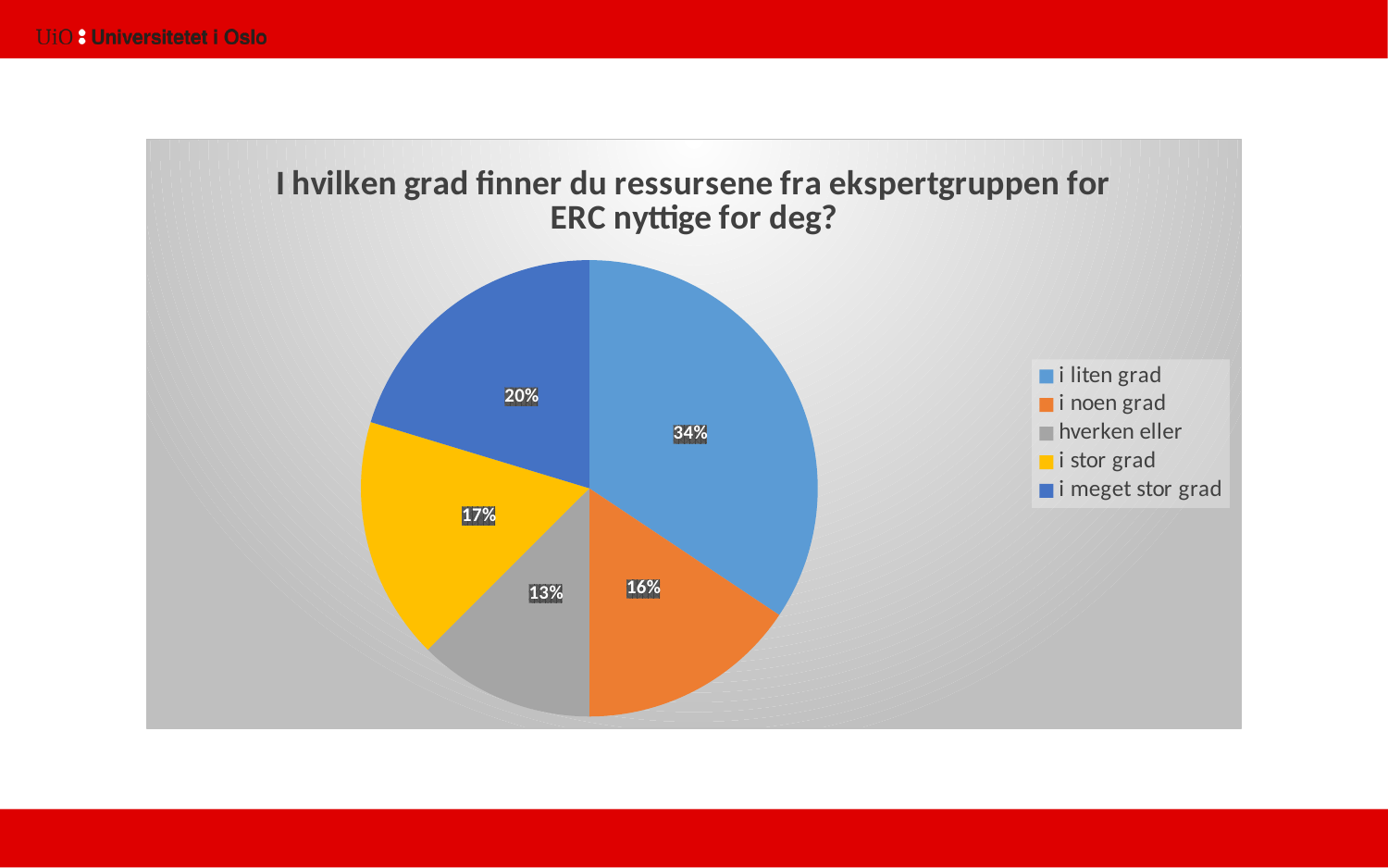
How many categories does the legend list? 5 What kind of chart is shown on the slide? pie chart Which category has the largest slice of the pie? i liten grad What share of the pie does "i noen grad" have? 16% What share of the pie does "i meget stor grad" have? 20% What is the difference in percentage points between "i liten grad" and "i meget stor grad"? 14 What share of the pie does "i liten grad" have? 34% Which is larger, the slice for "i stor grad" or the slice for "i noen grad"? i stor grad Which category has the smallest slice of the pie? hverken eller What is the title of the chart? I hvilken grad finner du ressursene fra ekspertgruppen for ERC nyttige for deg?